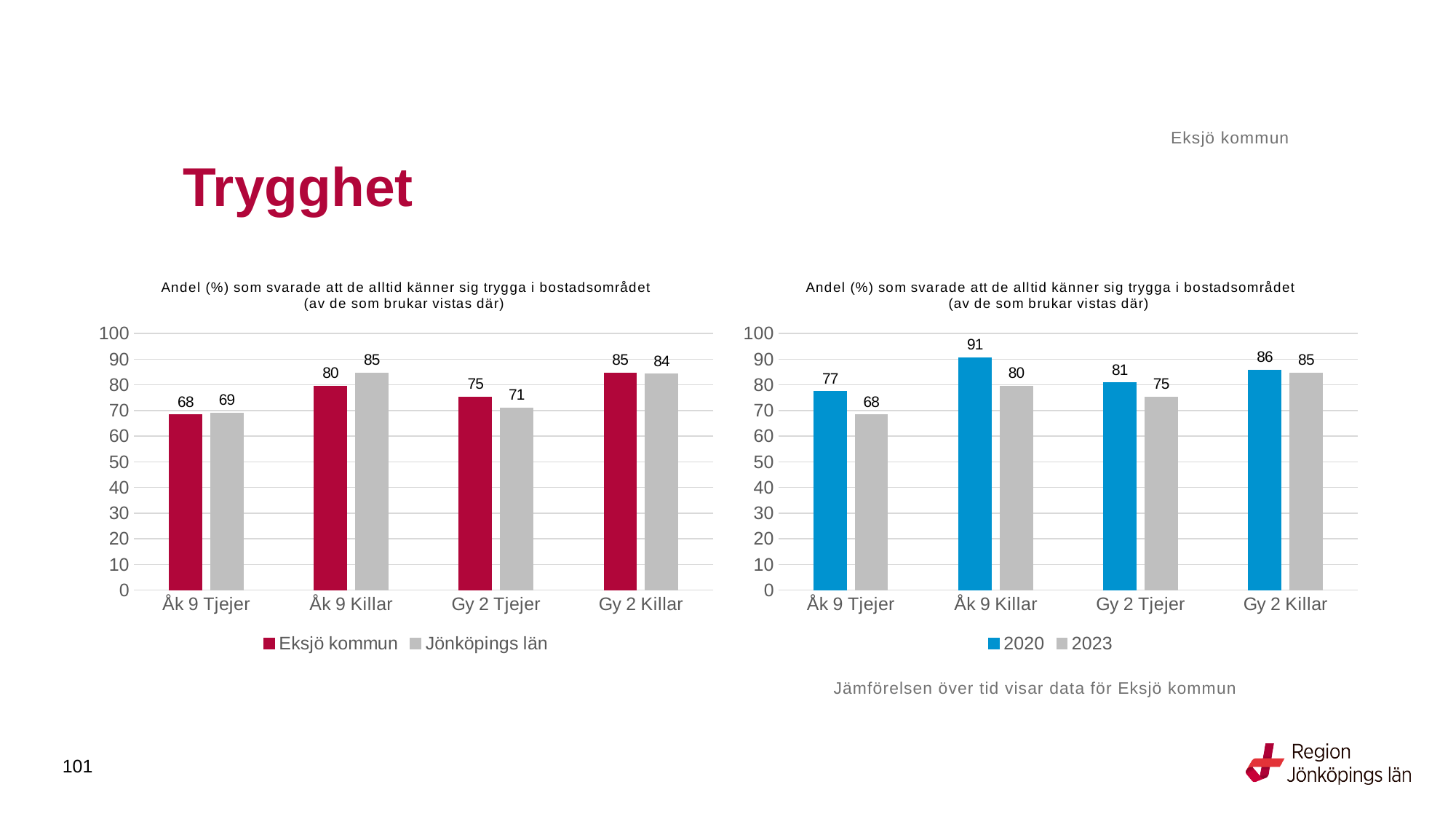
In the right chart, which category has the highest value for 2020? Åk 9 Killar In the left chart, what is the difference between Jönköpings län and Eksjö kommun for Åk 9 Killar? 5 In the left chart, what is the value for Jönköpings län for Gy 2 Tjejer? 71 In the right chart, what is the difference between 2020 and 2023 for Åk 9 Killar? 11 In the right chart, what is the value for 2020 for Åk 9 Killar? 91 How many categories are shown on the x axis of the left chart? 4 What type of chart is the left chart? Bar chart In the left chart, what is the value for Eksjö kommun for Åk 9 Killar? 80 In the right chart, what is the value for 2023 for Åk 9 Tjejer? 68 In the right chart, which is larger for Gy 2 Tjejer: 2020 or 2023? 2020 How many series does the legend of the right chart list? 2 In the left chart, which category has the lowest value for Eksjö kommun? Åk 9 Tjejer